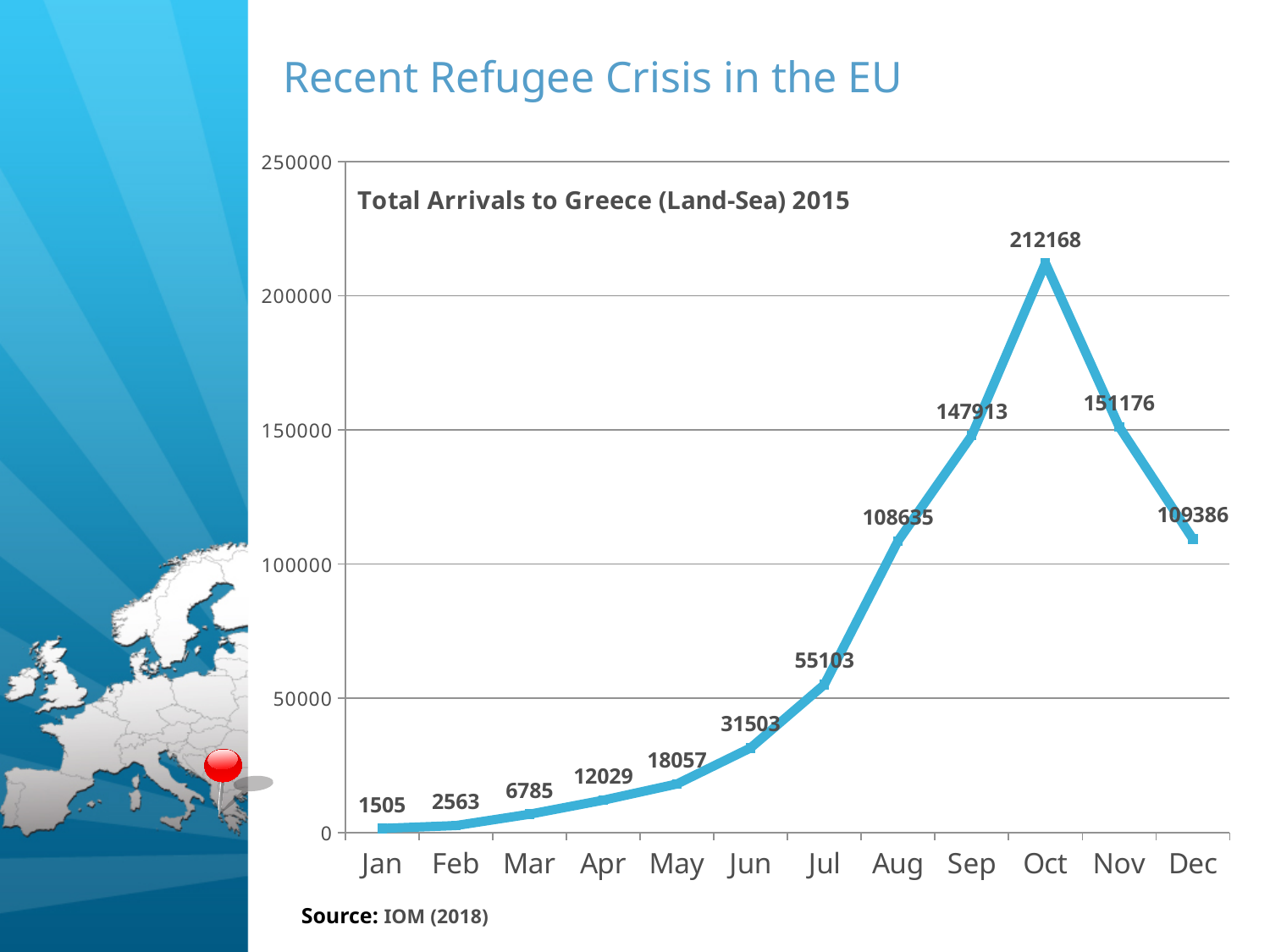
What is the difference between the values for Oct and Nov? 60992 Which month has the lowest value in the chart? Jan What is the title of the chart? Total Arrivals to Greece (Land-Sea) 2015 What is the value for Aug in the chart? 108635 Which month has the highest value in the chart? Oct What is the value for Oct in the Total Arrivals to Greece (Land-Sea) 2015 chart? 212168 How many months are plotted in the chart? 12 What is the value for Jan in the chart? 1505 What kind of chart is shown on the slide? line chart Is the value for Sep greater or less than 100000? greater Which is larger, the value for Nov or the value for Sep? Nov What is the difference between the values for Jul and Jun? 23600